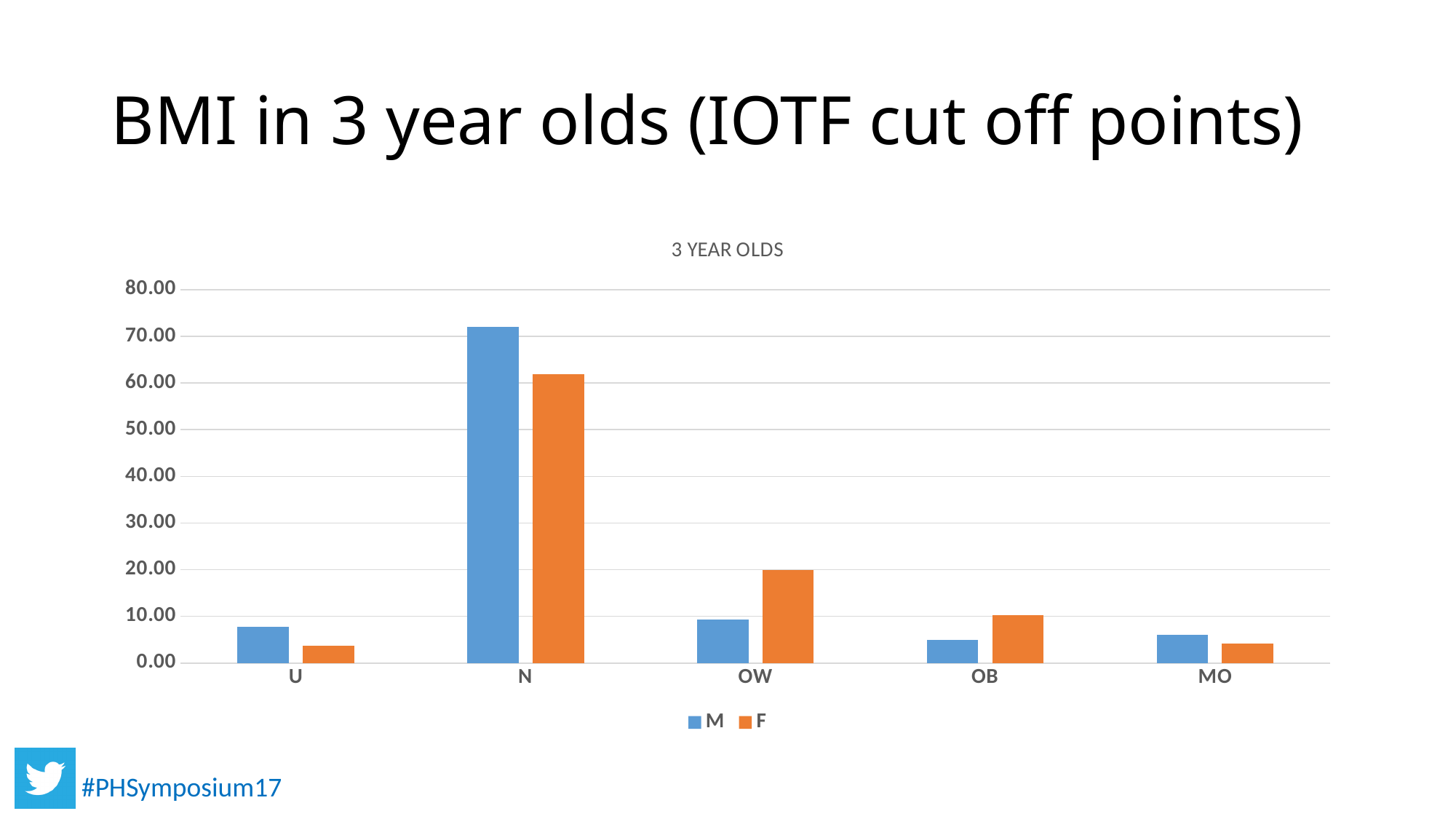
Is the value for F in category N greater or less than 70? less For category N, which series has the larger value, M or F? M Which category has the highest value for the F series? N Is the value for M in category N greater or less than 60? greater Is the value for F in category OW greater or less than 10? greater How many categories are shown on the x axis of the chart? 5 What is the title shown above the chart? 3 YEAR OLDS Which category has the highest value for the M series? N What kind of chart is shown on the slide? bar chart For category OB, which series has the larger value, M or F? F How many series does the legend list? 2 For category OW, which series has the larger value, M or F? F